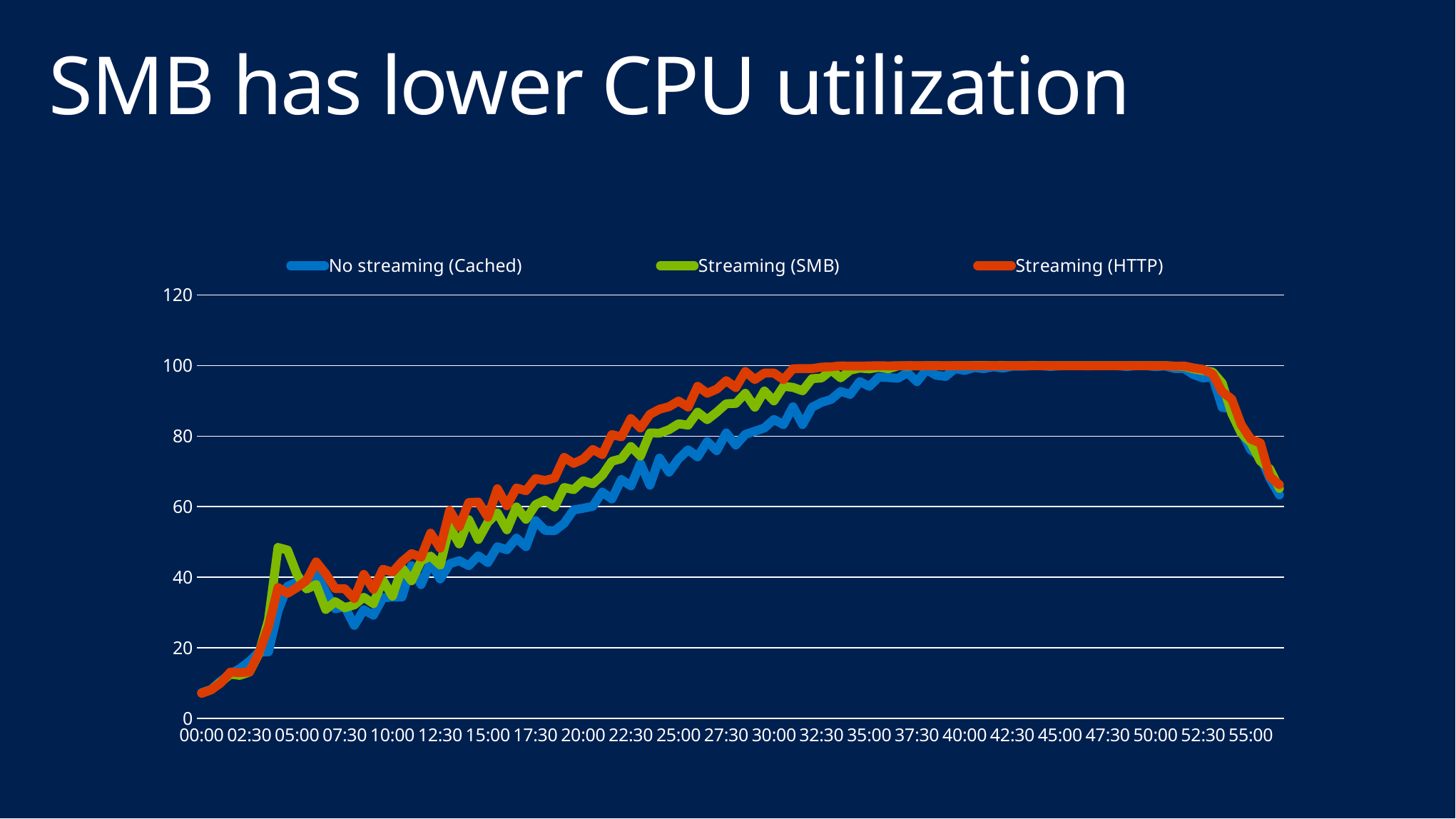
Is the value for Streaming (HTTP) at 00:00 greater or less than 20? less Is the value for No streaming (Cached) at 10:00 greater or less than 40? less Is the value for Streaming (HTTP) at 20:00 greater or less than 60? greater What are the three series named in the legend? No streaming (Cached), Streaming (SMB), Streaming (HTTP) At 12:30, which series has the lowest value? No streaming (Cached) What kind of chart is shown on the slide? line chart What is the title of the slide? SMB has lower CPU utilization Do the values for Streaming (SMB) rise or fall between 10:00 and 30:00? rise What is the highest value shown on the vertical axis? 120 How many series does the legend list? 3 At 25:00, which is larger: Streaming (HTTP) or No streaming (Cached)? Streaming (HTTP)